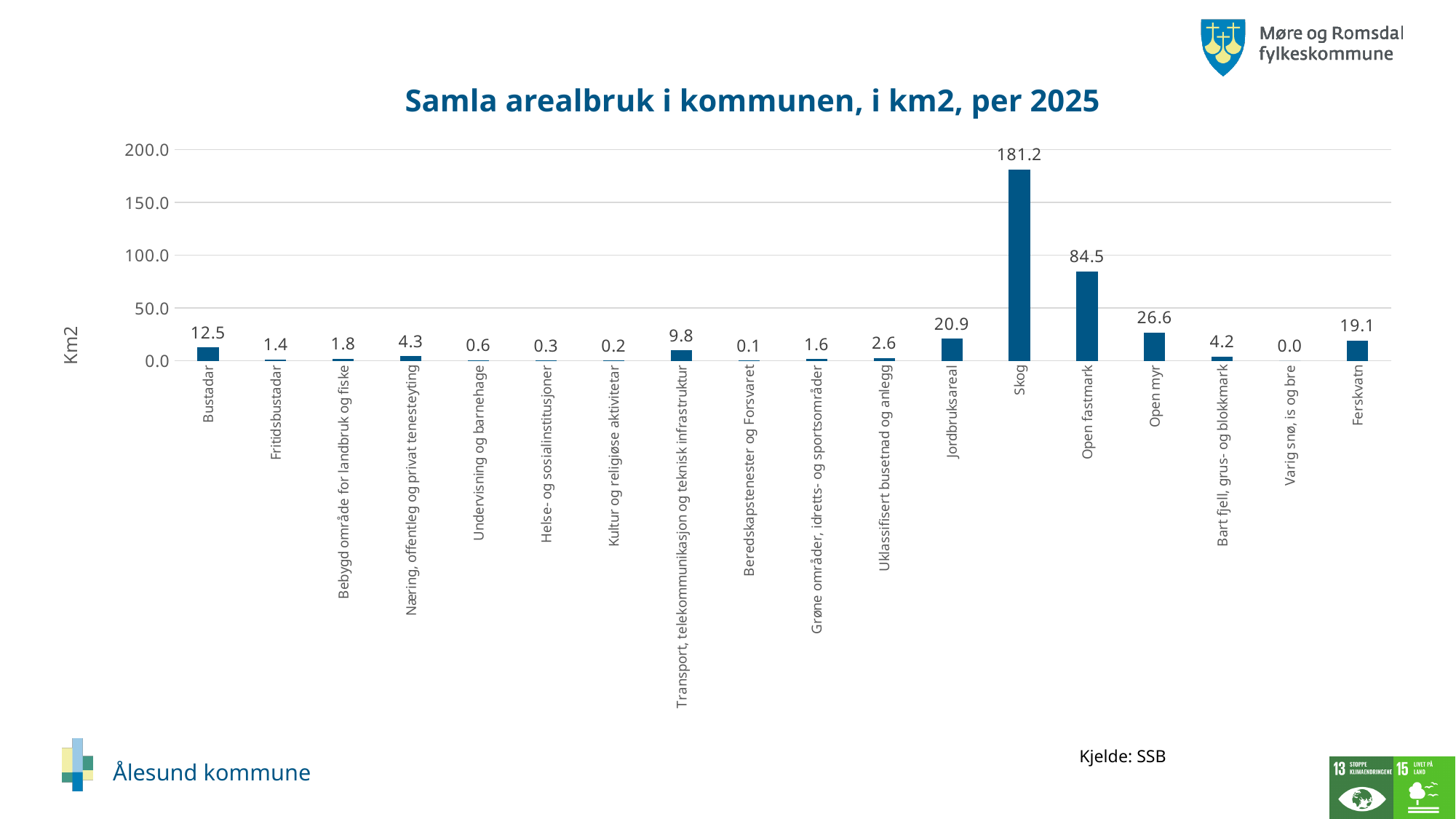
What kind of chart is shown on the slide? Bar chart What is the difference between the values for Skog and Open fastmark? 96.7 Which category has the highest value? Skog Is the value for Open fastmark greater or less than 100.0? less How many categories are shown on the x axis? 18 What is the value for Bustadar? 12.5 Which is larger, the value for Open myr or the value for Jordbruksareal? Open myr What is the value for Open fastmark? 84.5 Which category has the lowest value? Varig snø, is og bre What is the value for Ferskvatn? 19.1 What is the title of the chart? Samla arealbruk i kommunen, i km2, per 2025 What is the value for Skog? 181.2